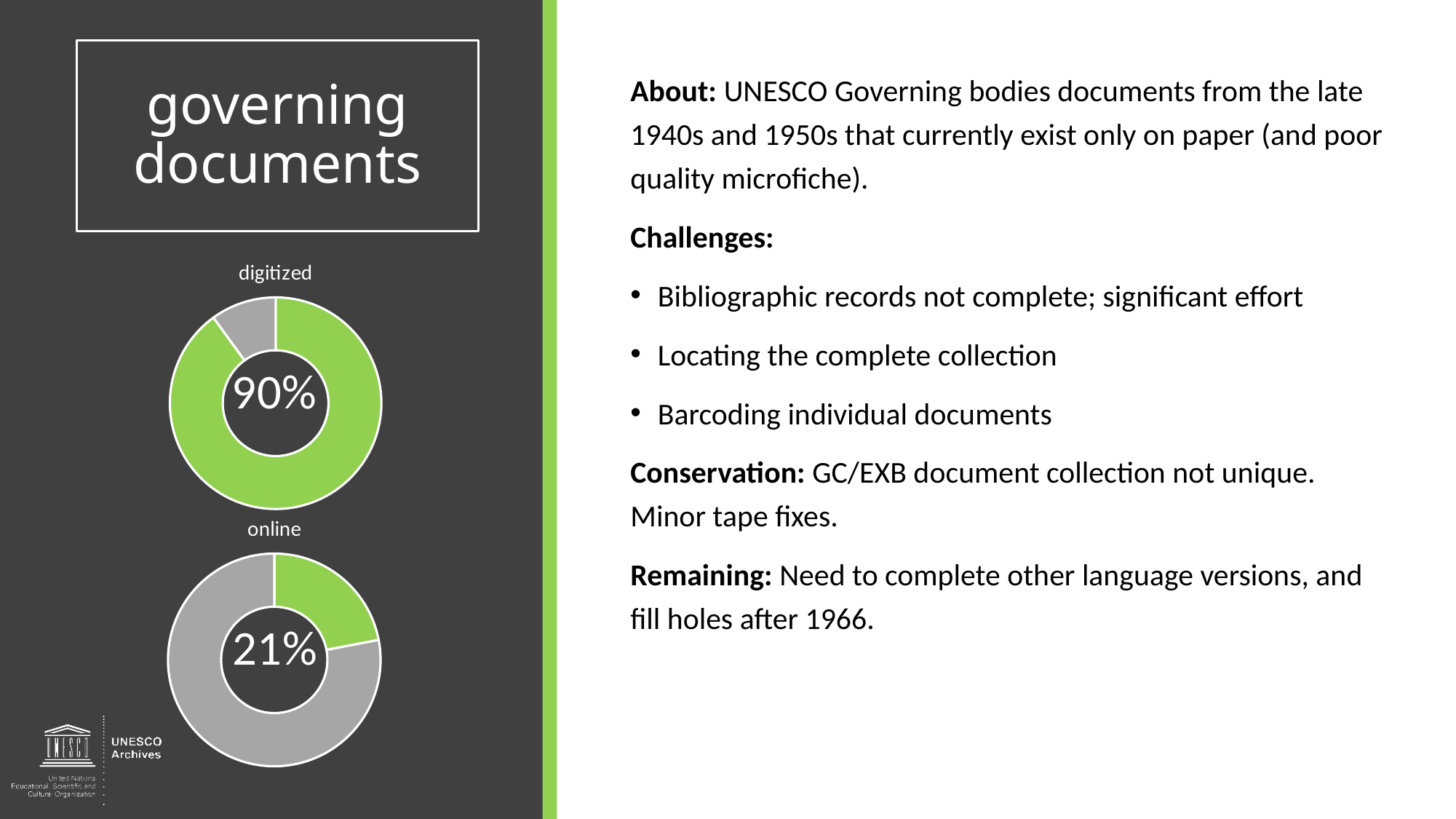
What is the difference between the 'digitized' percentage and the 'online' percentage? 69% What share of the 'digitized' donut chart is not green (the grey remainder)? 10% How many donut charts are on the slide? 2 In the 'digitized' donut chart, is the green slice greater or less than 50% of the ring? greater What colour is used for the completed portion in both donut charts? Green What share of the 'online' donut chart is grey? 79% What is the label above the lower donut chart? online Which chart shows the larger percentage, 'digitized' or 'online'? digitized What percentage is shown in the centre of the 'online' donut chart? 21% What kind of chart is used to show the 'digitized' figure? Donut (pie) chart In the 'online' donut chart, is the green slice greater or less than 50% of the ring? less What percentage is shown in the centre of the 'digitized' donut chart? 90%